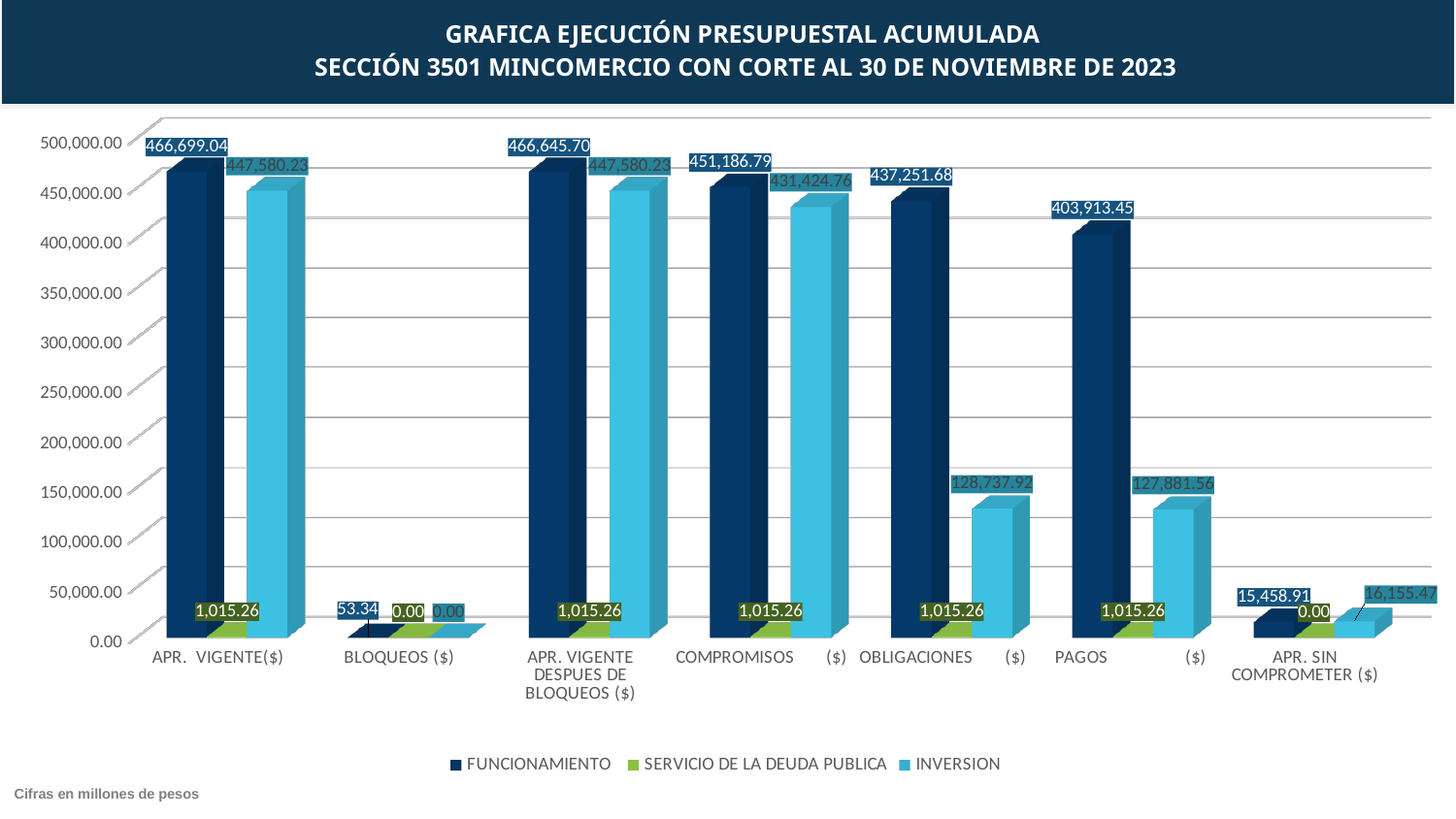
What is the FUNCIONAMIENTO value for PAGOS ($)? 403,913.45 What is the FUNCIONAMIENTO value for APR. VIGENTE($)? 466,699.04 Which category has the highest FUNCIONAMIENTO value? APR. VIGENTE($) How many series does the legend list? 3 What is the difference between the FUNCIONAMIENTO values for APR. VIGENTE($) and APR. VIGENTE DESPUES DE BLOQUEOS ($)? 53.34 How many categories are shown on the x axis? 7 Which is larger for OBLIGACIONES ($): the FUNCIONAMIENTO value or the INVERSION value? FUNCIONAMIENTO What is the difference between the INVERSION values for OBLIGACIONES ($) and PAGOS ($)? 856.36 Which category has the lowest FUNCIONAMIENTO value? BLOQUEOS ($) What is the INVERSION value for APR. SIN COMPROMETER ($)? 16,155.47 What kind of chart is shown on the slide? Bar chart What is the INVERSION value for COMPROMISOS ($)? 431,424.76